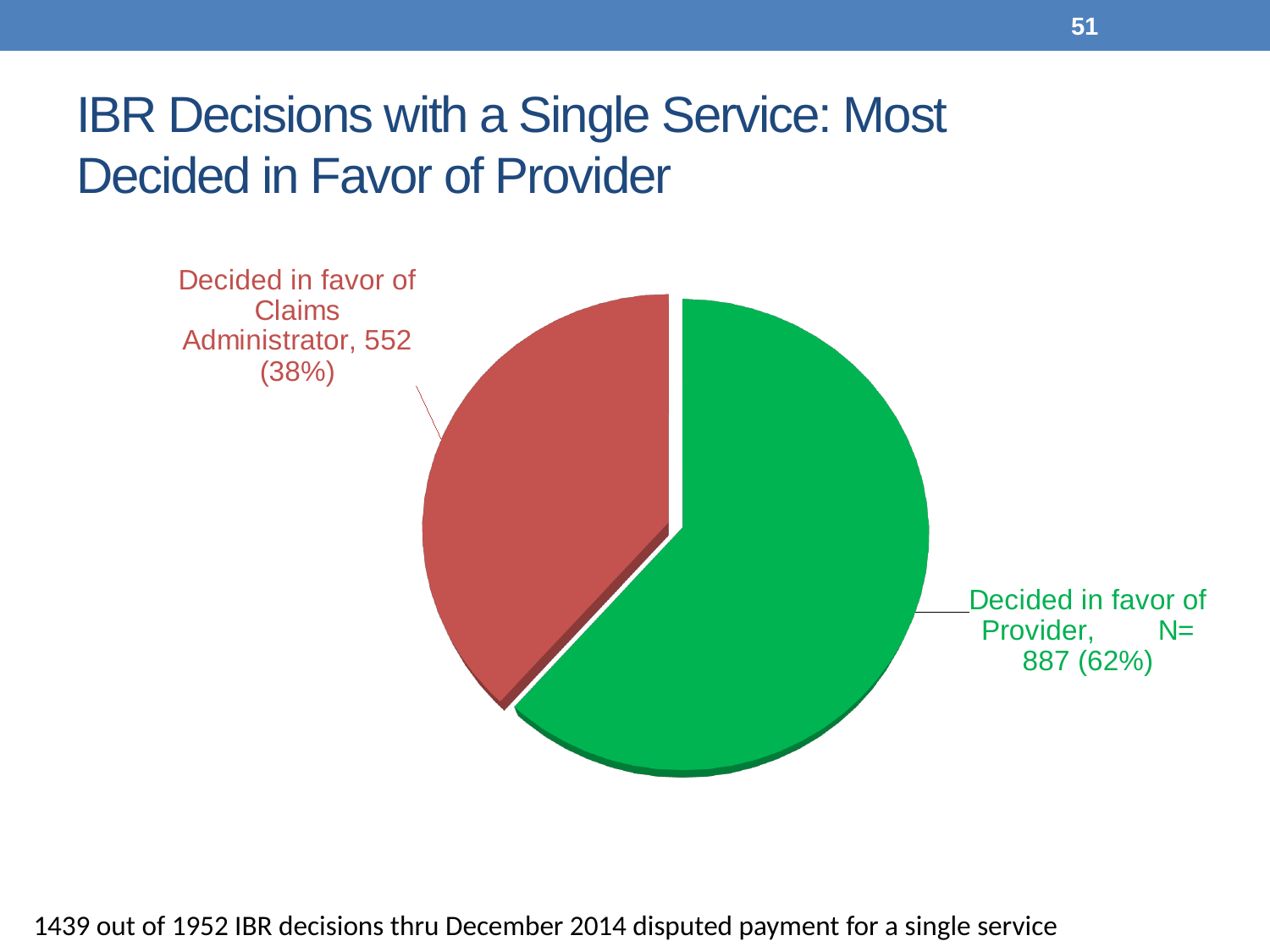
Which slice of the pie is the largest? Decided in favor of Provider What share of the pie is the 'Decided in favor of Provider' slice? 62% What colour is the 'Decided in favor of Provider' slice? green How many IBR decisions were decided in favor of the Provider? 887 What is the total number of decisions represented in the pie chart? 1439 Which slice of the pie is the smallest? Decided in favor of Claims Administrator What share of the pie is the 'Decided in favor of Claims Administrator' slice? 38% What kind of chart is shown on the slide? pie chart What is the difference between the number of decisions in favor of the Provider and the number in favor of the Claims Administrator? 335 How many slices does the pie chart have? 2 Which is larger: the number of decisions in favor of the Provider or in favor of the Claims Administrator? Decided in favor of Provider How many IBR decisions were decided in favor of the Claims Administrator? 552